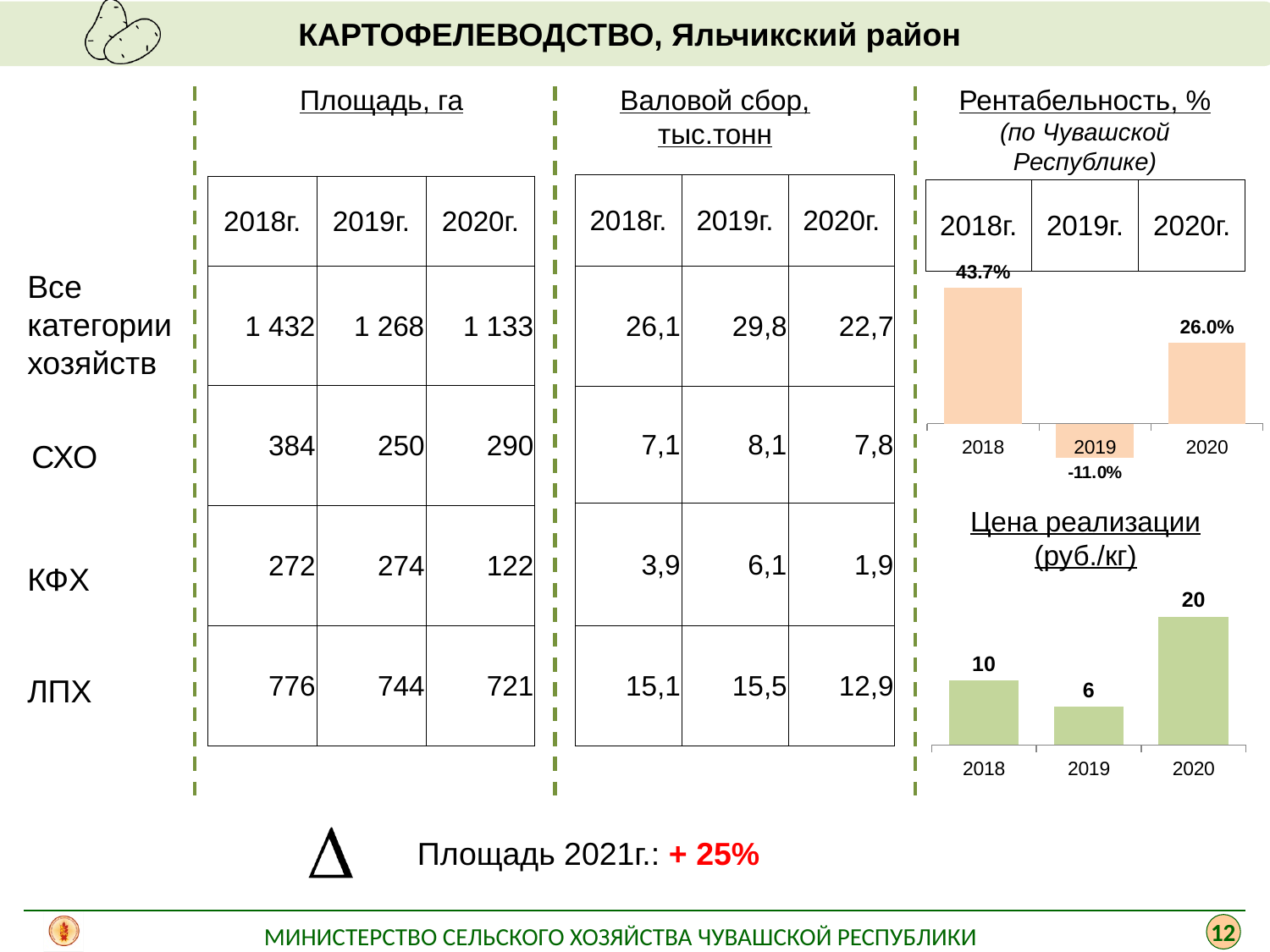
In the 'Цена реализации (руб./кг)' chart, which year has the highest value? 2020 In the 'Рентабельность, %' chart, what is the value for 2018? 43.7% In the 'Рентабельность, %' chart, what is the value for 2019? -11.0% In the 'Цена реализации (руб./кг)' chart, is the value for 2018 larger or smaller than the value for 2019? larger In the 'Рентабельность, %' chart, which year has the lowest value? 2019 In the 'Рентабельность, %' chart, what is the difference between the 2018 and 2020 values? 17.7% In the 'Цена реализации (руб./кг)' chart, what is the value for 2019? 6 In the 'Цена реализации (руб./кг)' chart, what is the difference between the 2020 and 2018 values? 10 What type of chart is the 'Цена реализации (руб./кг)' chart? bar chart In the 'Рентабельность, %' chart, how many years are plotted? 3 In the 'Рентабельность, %' chart, which year has the highest value? 2018 In the 'Цена реализации (руб./кг)' chart, what is the value for 2020? 20